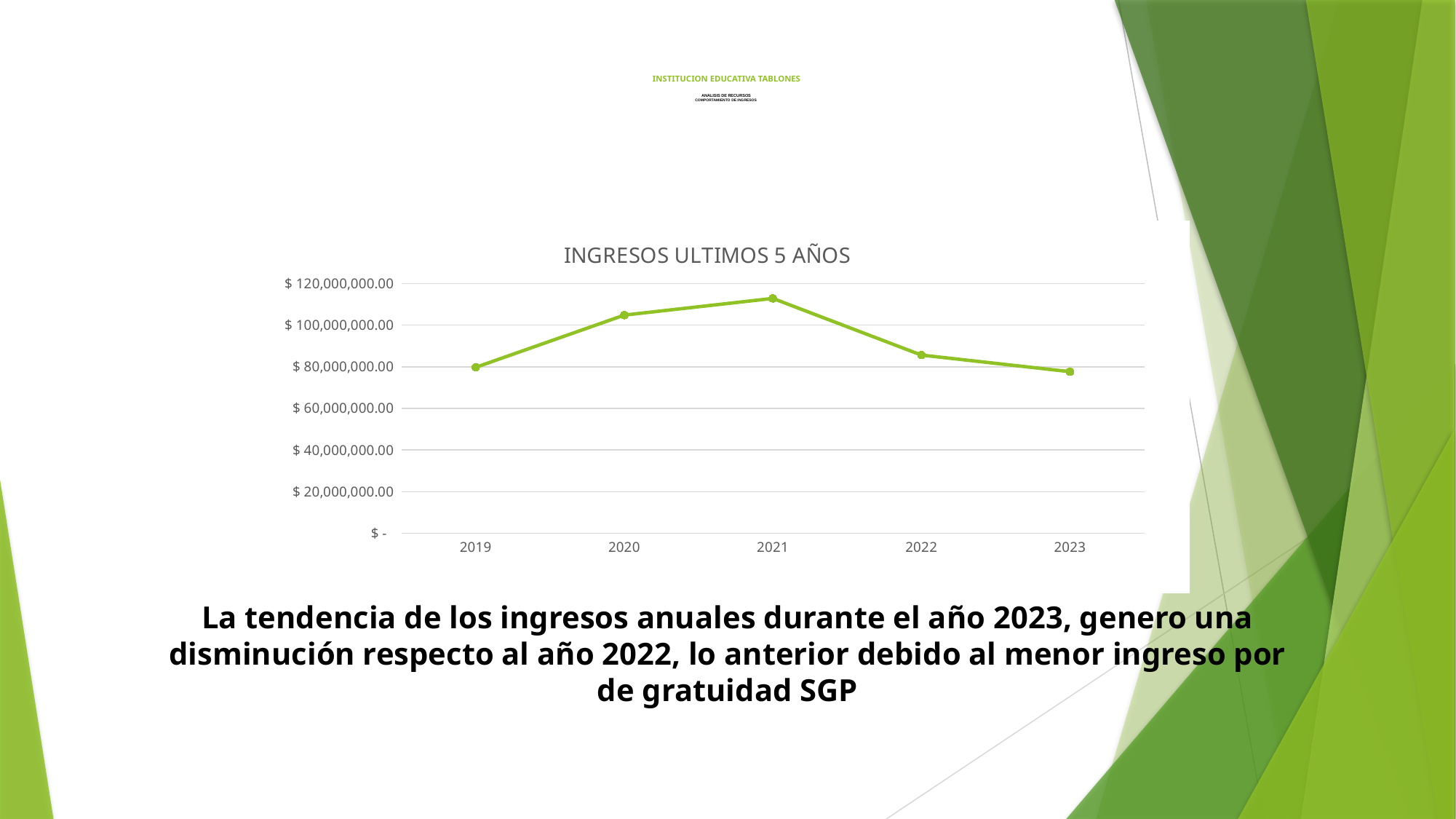
Is the value for 2022 greater or less than $ 80,000,000.00? greater Is the value for 2020 greater or less than $ 100,000,000.00? greater How many years are plotted on the x axis of the chart? 5 How do the values change from 2021 to 2023? They fall Is the value for 2022 greater or less than $ 100,000,000.00? less What is the title of the chart? INGRESOS ULTIMOS 5 AÑOS Which is larger, the value for 2020 or the value for 2022? 2020 Which is larger, the value for 2021 or the value for 2019? 2021 Which year has the highest value in the chart? 2021 What kind of chart is shown on the slide? Line chart